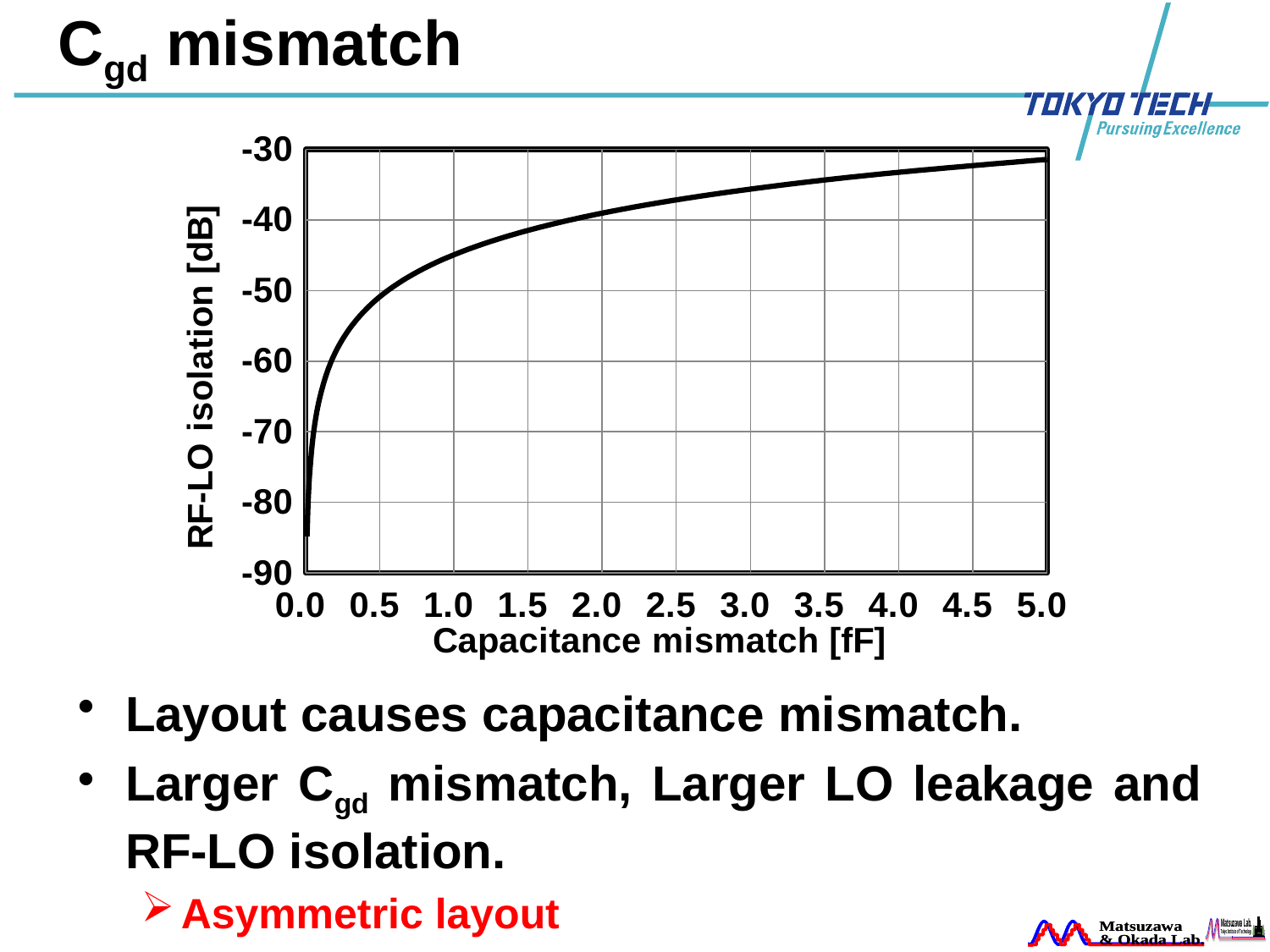
Is the RF-LO isolation larger at 4.0 fF or at 0.5 fF of capacitance mismatch? 4.0 fF Is the RF-LO isolation at a capacitance mismatch of 3.0 fF greater or less than -40 dB? greater Does the RF-LO isolation rise or fall as the capacitance mismatch increases along the x axis? rise At which capacitance mismatch value on the x axis is the RF-LO isolation highest? 5.0 fF What is the label of the x axis? Capacitance mismatch [fF] Is the RF-LO isolation at a capacitance mismatch of 0.2 fF greater or less than -70 dB? greater Is the RF-LO isolation at a capacitance mismatch of 1.0 fF greater or less than -50 dB? greater What is the label of the y axis? RF-LO isolation [dB] What kind of chart is shown on the slide? line chart At which end of the x axis is the RF-LO isolation lowest? 0.0 fF